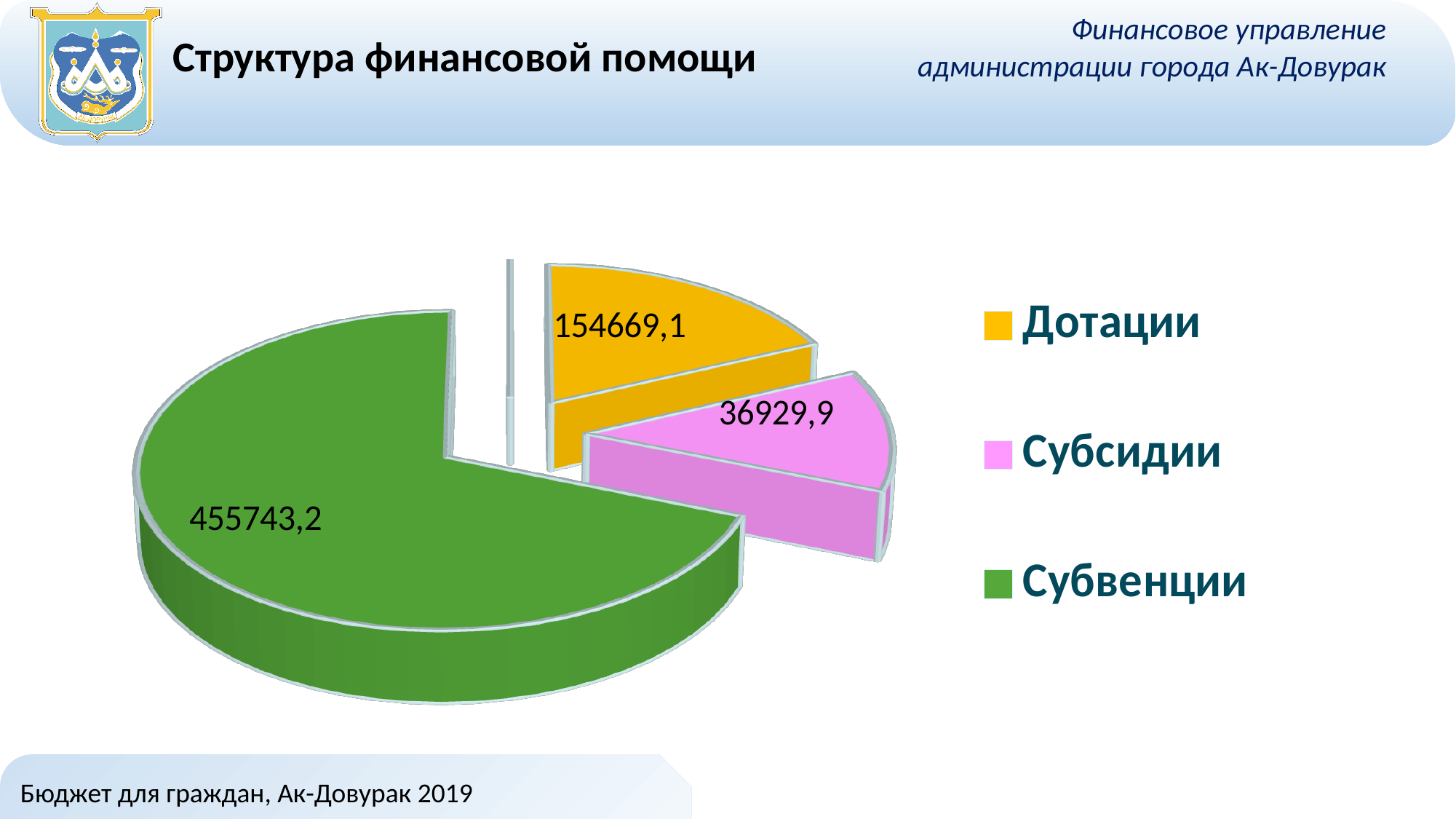
What type of chart is shown on the slide? Pie chart What is the value shown for Дотации in the pie chart? 154669,1 What is the value shown for Субсидии in the pie chart? 36929,9 Which colour represents Субвенции in the pie chart? Green What is the difference between the values for Субвенции and Дотации? 301074,1 What is the difference between the values for Дотации and Субсидии? 117739,2 Which category has the smallest slice in the pie chart? Субсидии What is the value shown for Субвенции in the pie chart? 455743,2 What is the title of the chart on the slide? Структура финансовой помощи How many categories are shown in the pie chart? 3 Which is larger, the value for Дотации or the value for Субсидии? Дотации Which category has the largest slice in the pie chart? Субвенции